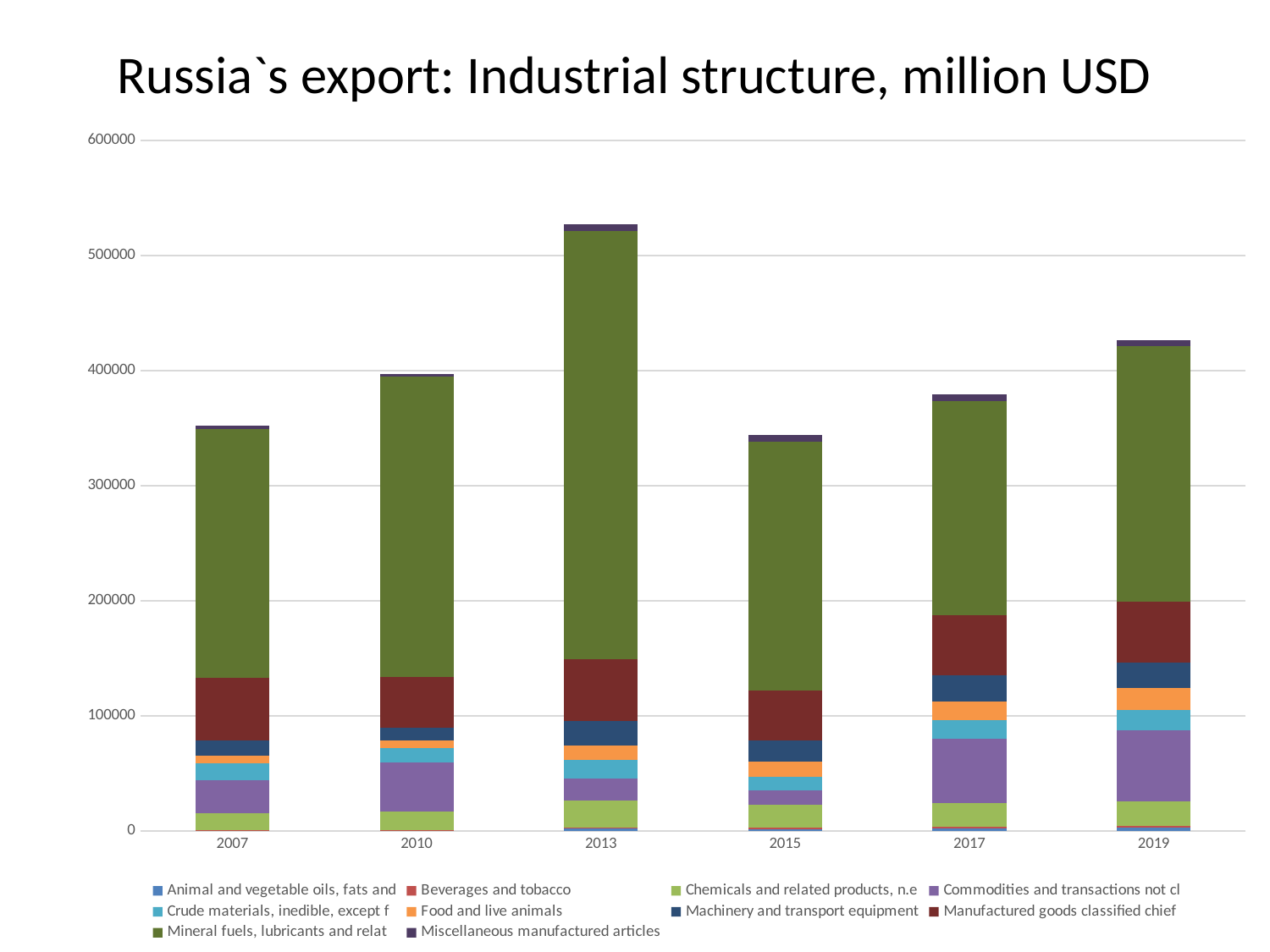
How many series does the legend list? 10 Is the total export value for 2015 greater or less than 400000? less Is the total export value for 2019 greater or less than 400000? greater What is the title of the chart? Russia`s export: Industrial structure, million USD Which series makes up the largest segment of every bar in the chart? Mineral fuels, lubricants and relat How many years are shown on the x axis of the chart? 6 Is the total export value for 2013 greater or less than 500000? greater Which year has the larger total export value, 2013 or 2019? 2013 What kind of chart is shown on the slide? Stacked bar chart Which year has the highest total export value? 2013 Which year has the larger total export value, 2017 or 2019? 2019